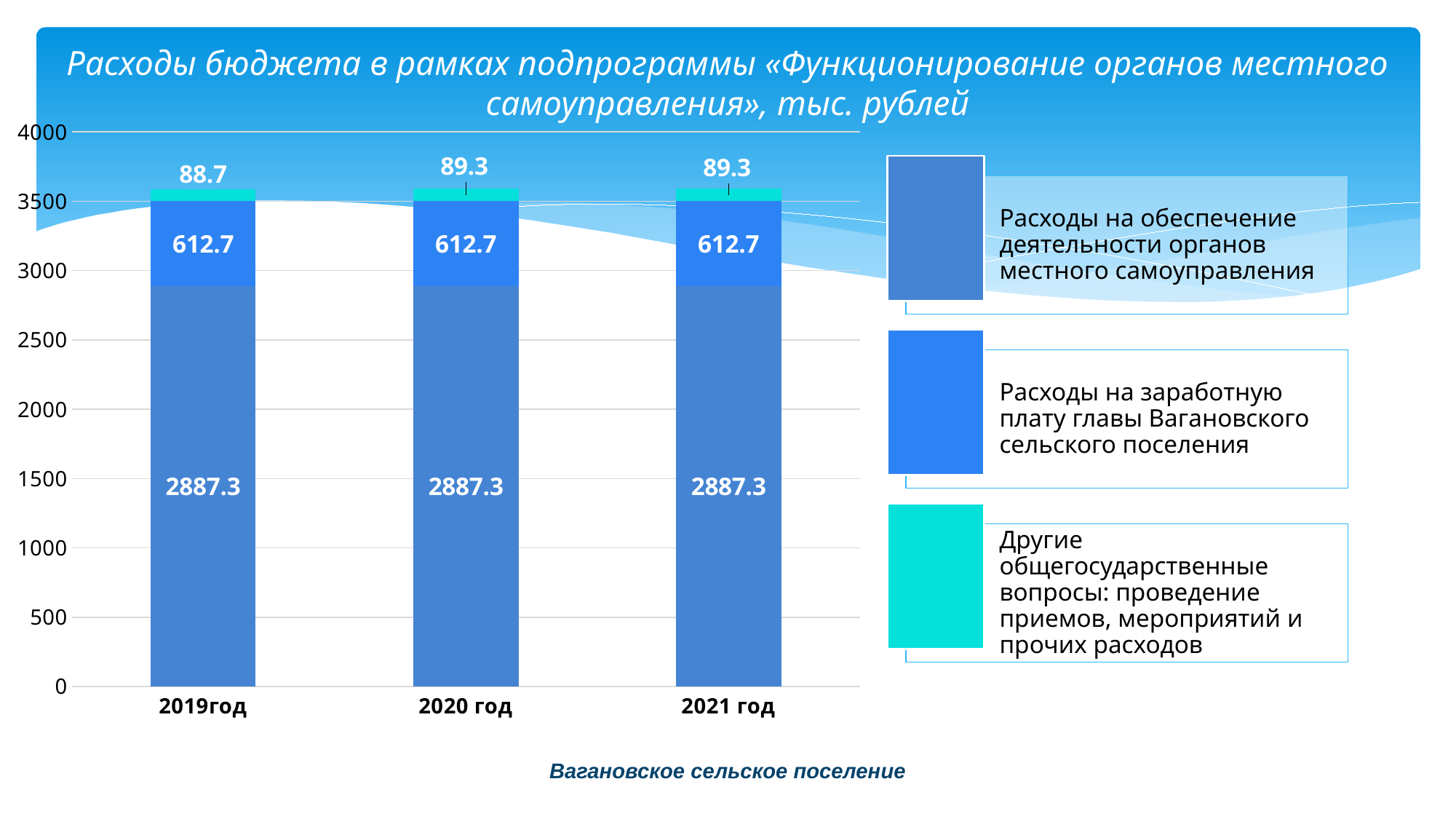
What is the difference between the 'Другие общегосударственные вопросы' values for 2020 год and 2019 год? 0.6 How many years (categories) are shown on the x axis? 3 What is the total of the stacked bar for 2021 год? 3589.3 What is the difference between 'Расходы на обеспечение деятельности органов местного самоуправления' and 'Расходы на заработную плату главы Вагановского сельского поселения' for 2020 год? 2274.6 What type of chart is shown on the slide? stacked bar chart How many series does the legend list? 3 What is the total of the stacked bar for 2019 год? 3588.7 What is the value of 'Расходы на заработную плату главы Вагановского сельского поселения' for 2021 год? 612.7 Which series has the largest value in 2021 год? Расходы на обеспечение деятельности органов местного самоуправления What is the value of 'Другие общегосударственные вопросы' for 2020 год? 89.3 What is the value of 'Другие общегосударственные вопросы' for 2019 год? 88.7 What is the value of 'Расходы на обеспечение деятельности органов местного самоуправления' for 2019 год? 2887.3